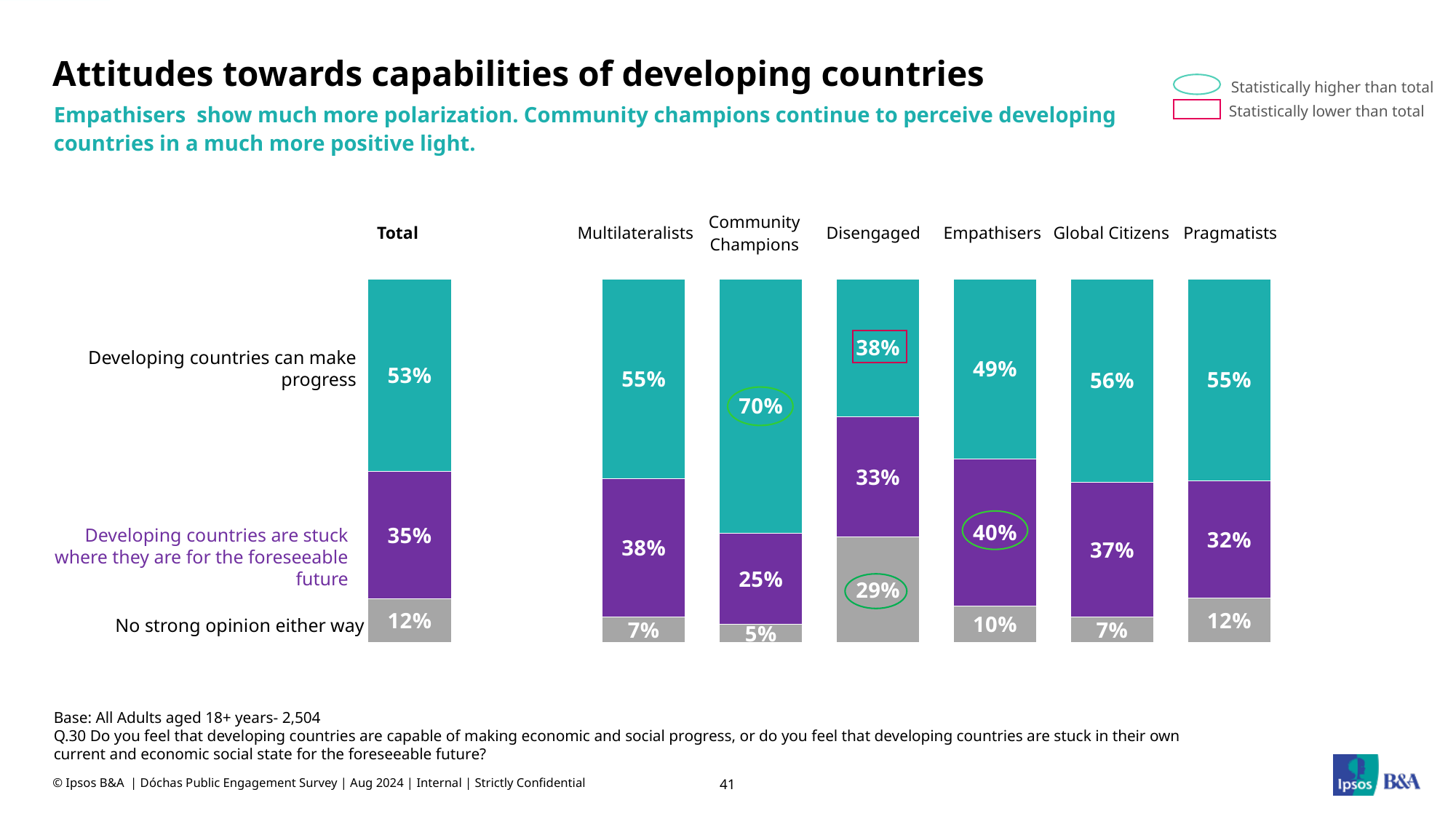
How many response categories are stacked in each bar? 3 What percentage of the Disengaged group have no strong opinion either way? 29% What percentage of Empathisers say developing countries are stuck where they are for the foreseeable future? 40% Which is larger: the 'stuck where they are' percentage for Multilateralists or for Pragmatists? Multilateralists How many groups (bars) are shown in the chart? 7 Which group has the lowest percentage saying developing countries can make progress? Disengaged Which group has the highest percentage saying developing countries can make progress? Community Champions What percentage of the Total group say developing countries can make progress? 53% Which group's 'Developing countries can make progress' value is marked as statistically lower than total? Disengaged What type of chart is shown on the slide? Stacked bar chart Which group has the lowest percentage with no strong opinion either way? Community Champions What is the difference between the Community Champions and Disengaged percentages for 'Developing countries can make progress'? 32 percentage points